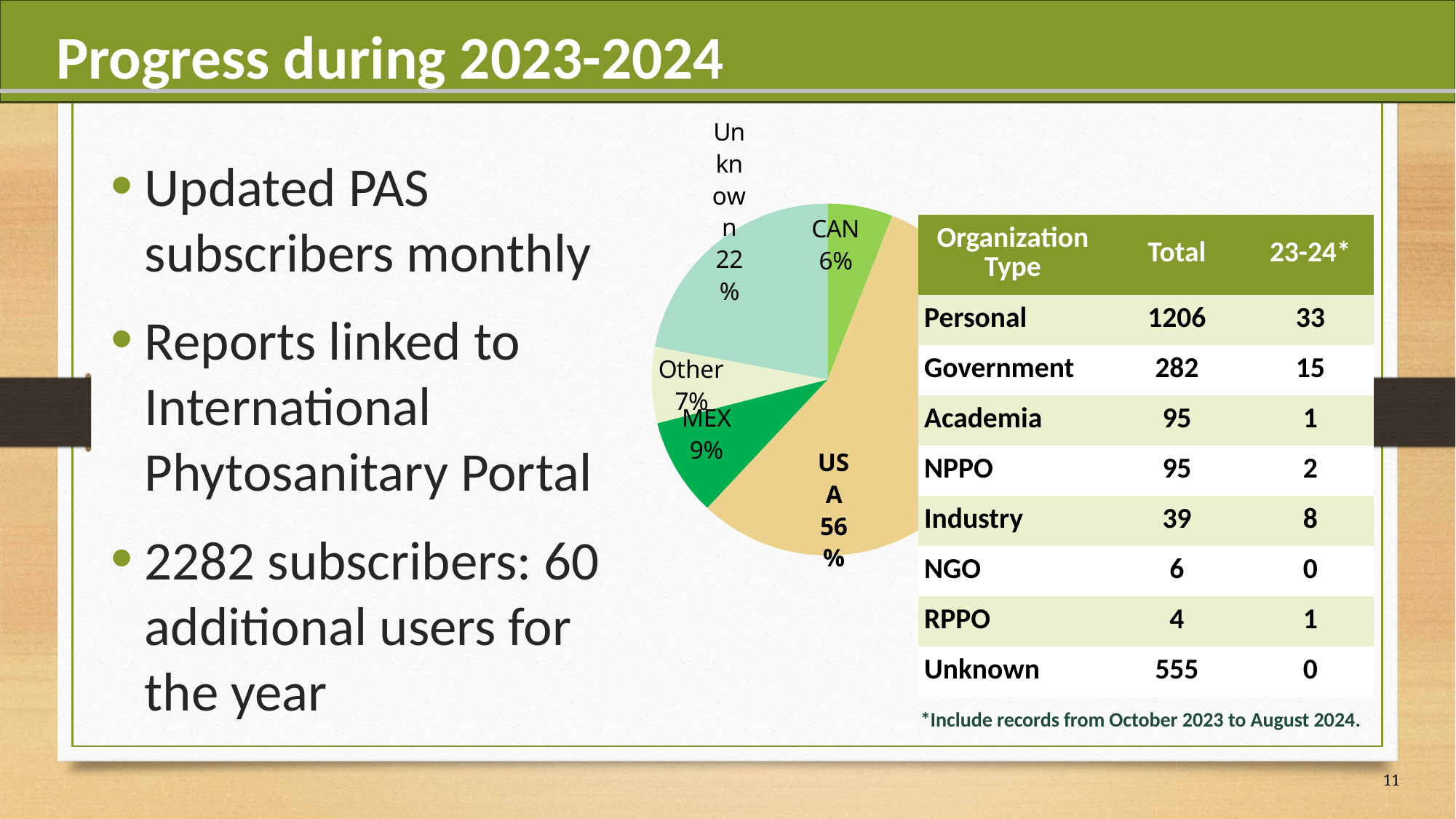
In the pie chart, what share does USA have? 56% In the pie chart, which is larger, the MEX slice or the Other slice? MEX In the pie chart, what share does MEX have? 9% In the pie chart, what is the difference in percentage points between the USA slice and the Unknown slice? 34 What kind of chart is shown on the slide? pie chart How many slices does the pie chart have? 5 In the pie chart, what share does Unknown have? 22% Which slice of the pie chart is the smallest? CAN In the pie chart, what colour is the MEX slice? green Which slice of the pie chart is the largest? USA